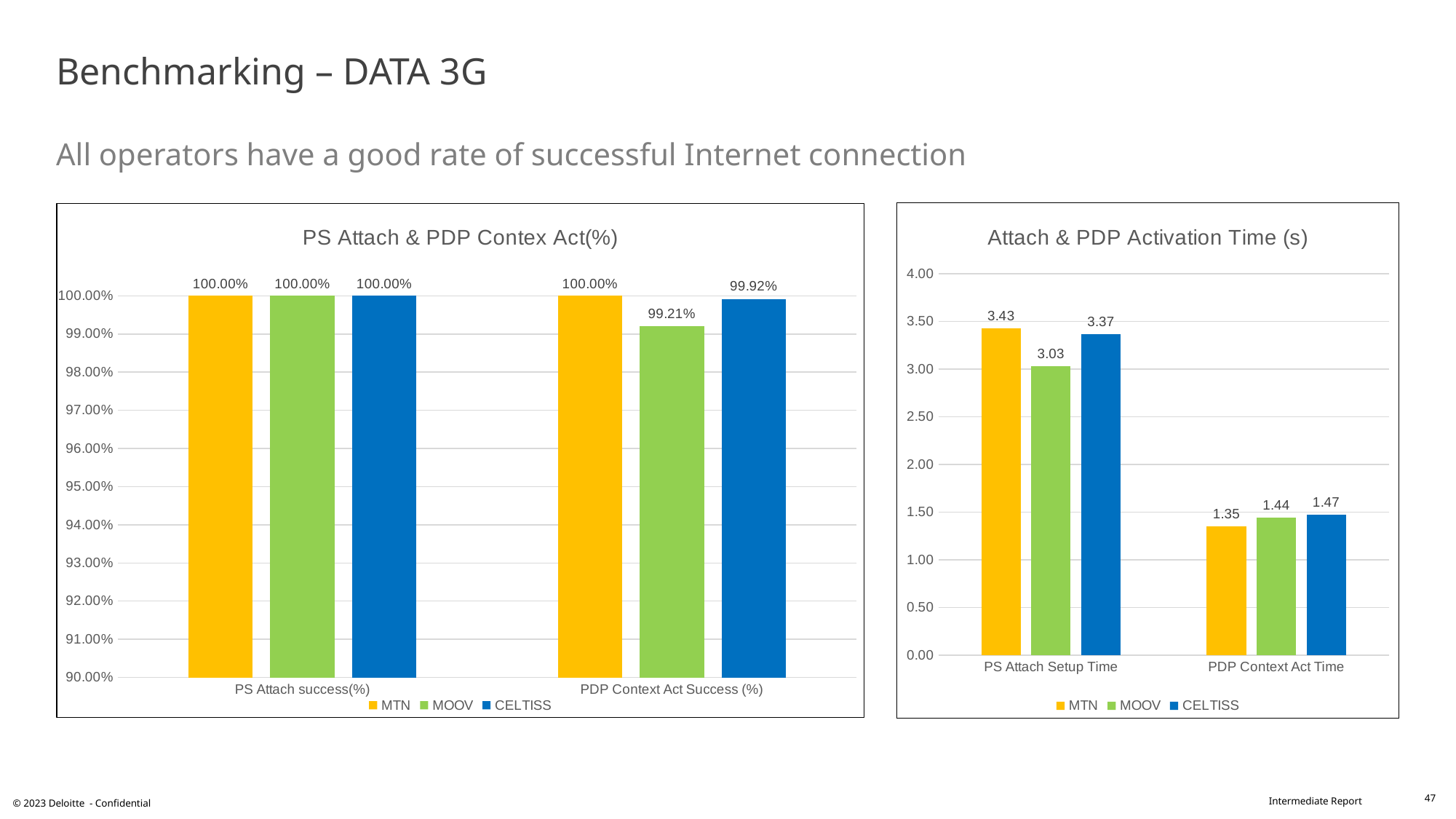
In the 'Attach & PDP Activation Time (s)' chart, what is the PDP Context Act Time for CELTISS? 1.47 In the 'Attach & PDP Activation Time (s)' chart, is the PS Attach Setup Time for MTN greater or less than 3.00? greater What kind of chart is the 'PS Attach & PDP Contex Act(%)' chart? bar chart In the 'PS Attach & PDP Contex Act(%)' chart, what is the PDP Context Act Success value for CELTISS? 99.92% In the 'Attach & PDP Activation Time (s)' chart, what is the PS Attach Setup Time for MOOV? 3.03 In the 'Attach & PDP Activation Time (s)' chart, which operator has the lowest PDP Context Act Time? MTN In the 'PS Attach & PDP Contex Act(%)' chart, which operator has the lowest PDP Context Act Success? MOOV In the 'Attach & PDP Activation Time (s)' chart, what is the difference between MTN and MOOV for PS Attach Setup Time? 0.40 In the 'Attach & PDP Activation Time (s)' chart, which operator has the highest PS Attach Setup Time? MTN How many series does the legend of the 'Attach & PDP Activation Time (s)' chart list? 3 In the 'PS Attach & PDP Contex Act(%)' chart, what is the PDP Context Act Success value for MOOV? 99.21% In the 'PS Attach & PDP Contex Act(%)' chart, what is the difference between CELTISS and MOOV for PDP Context Act Success? 0.71%